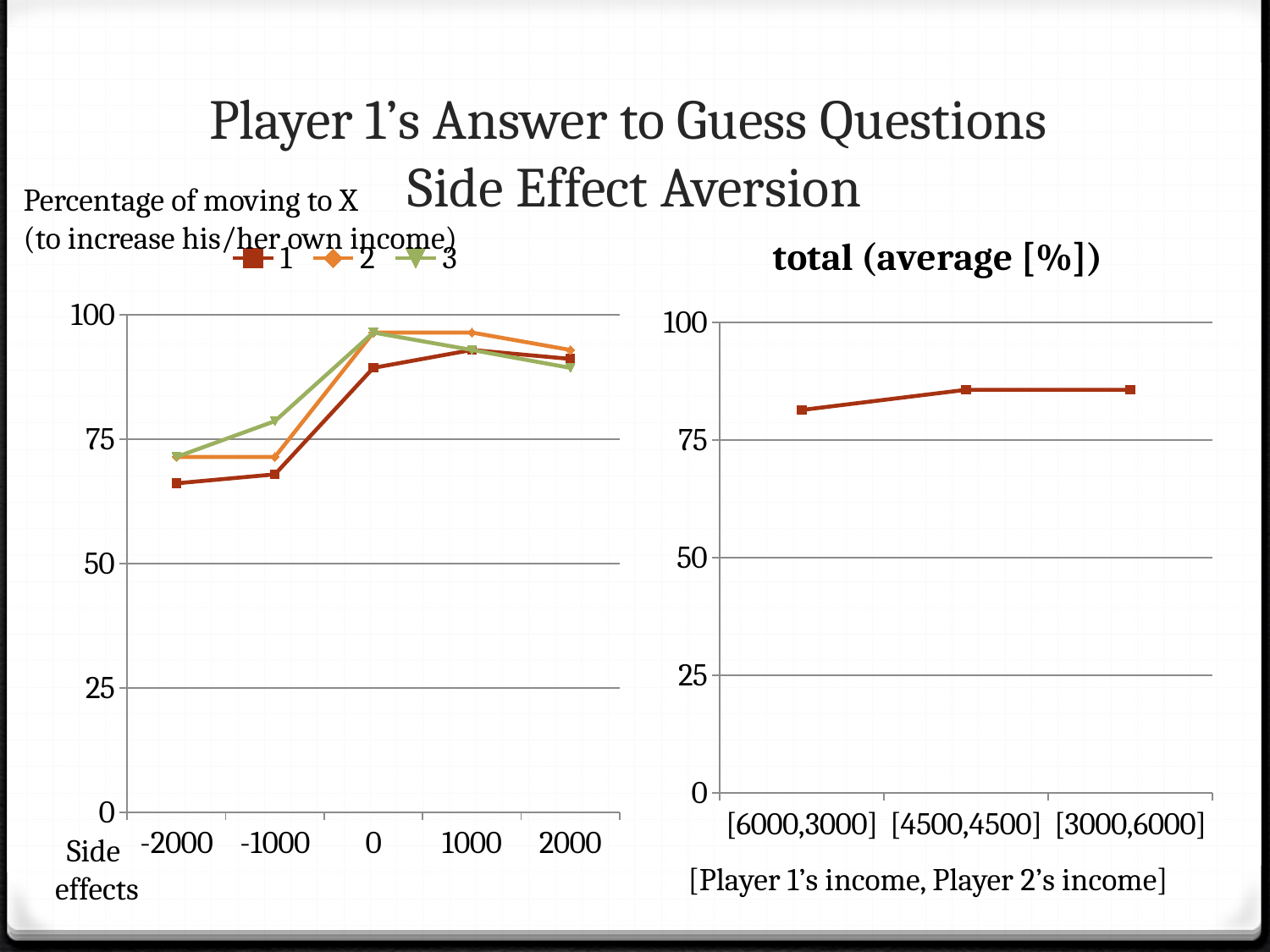
In the left chart, at side effect -1000, which series has the higher value, series 1 or series 3? series 3 How many series does the legend of the left chart list? 3 In the right chart 'total (average [%])', is the value for [6000,3000] greater or less than 75? greater How many side-effect values are plotted along the x axis of the left chart? 5 In the right chart 'total (average [%])', which income pair has the lowest value? [6000,3000] In the left chart, is the value for series 2 at side effect 0 greater or less than 75? greater What kind of chart is the left chart (Percentage of moving to X)? line chart How many income pairs are plotted on the x axis of the right chart 'total (average [%])'? 3 In the left chart, does series 1 rise or fall from side effect -2000 to side effect 1000? rise What kind of chart is the right chart titled 'total (average [%])'? line chart In the left chart, which series has the lowest value at side effect -2000? series 1 In the left chart, is the value for series 1 at side effect -2000 greater or less than 75? less